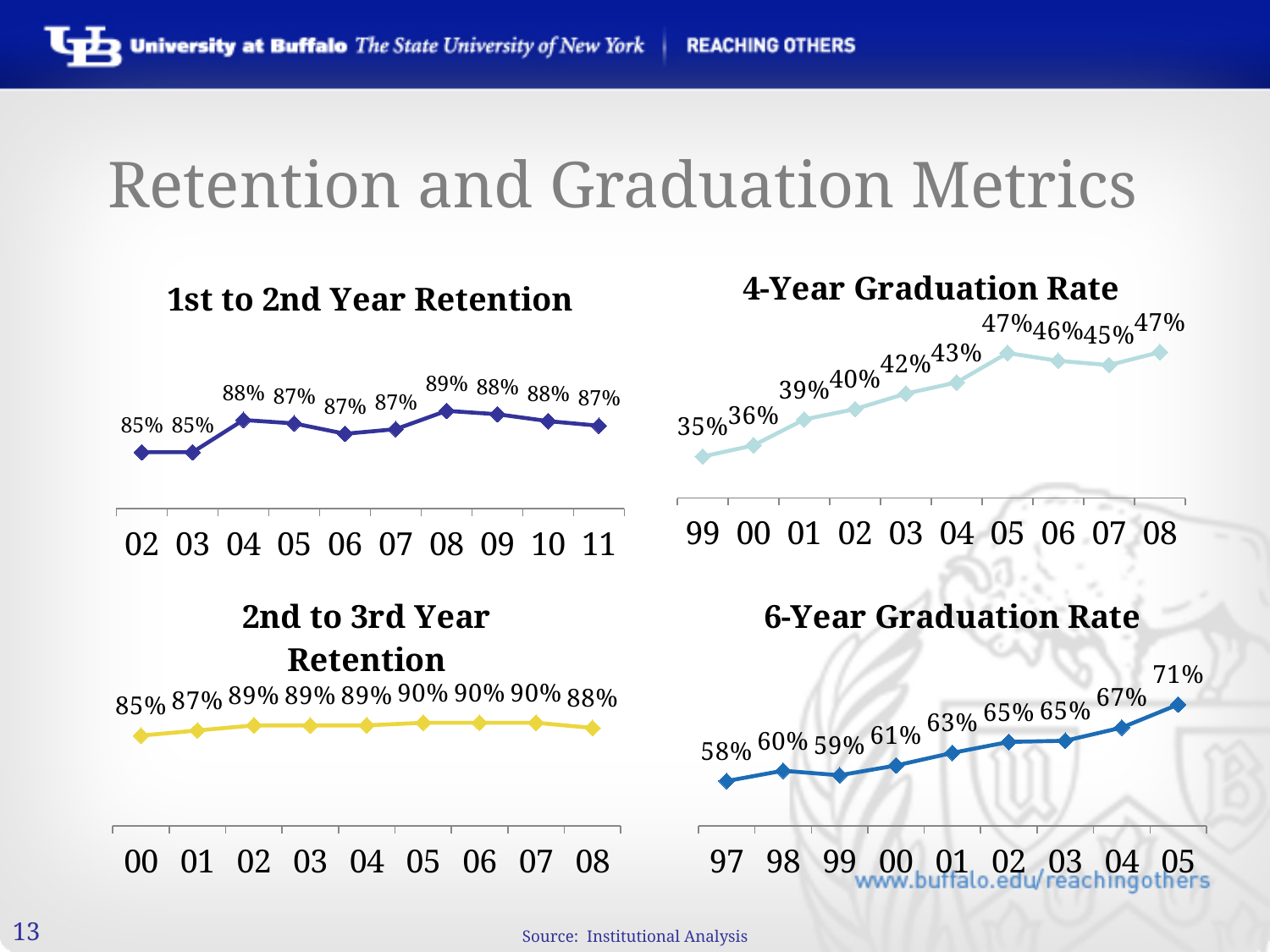
In the '6-Year Graduation Rate' chart, which year has the highest value? 05 In the '4-Year Graduation Rate' chart, what is the value for 99? 35% In the '1st to 2nd Year Retention' chart, what is the value for 08? 89% In the '2nd to 3rd Year Retention' chart, what is the value for 00? 85% What kind of chart is the '4-Year Graduation Rate' chart? Line chart In the '4-Year Graduation Rate' chart, what is the difference between the values for 08 and 99? 12% In the '6-Year Graduation Rate' chart, do the values generally rise or fall from 97 to 05? Rise In the '1st to 2nd Year Retention' chart, how many years are shown on the x axis? 10 In the '1st to 2nd Year Retention' chart, what is the value for 02? 85% In the '6-Year Graduation Rate' chart, which year has the lowest value? 97 In the '2nd to 3rd Year Retention' chart, how many data points are plotted? 9 In the '6-Year Graduation Rate' chart, what is the value for 04? 67%